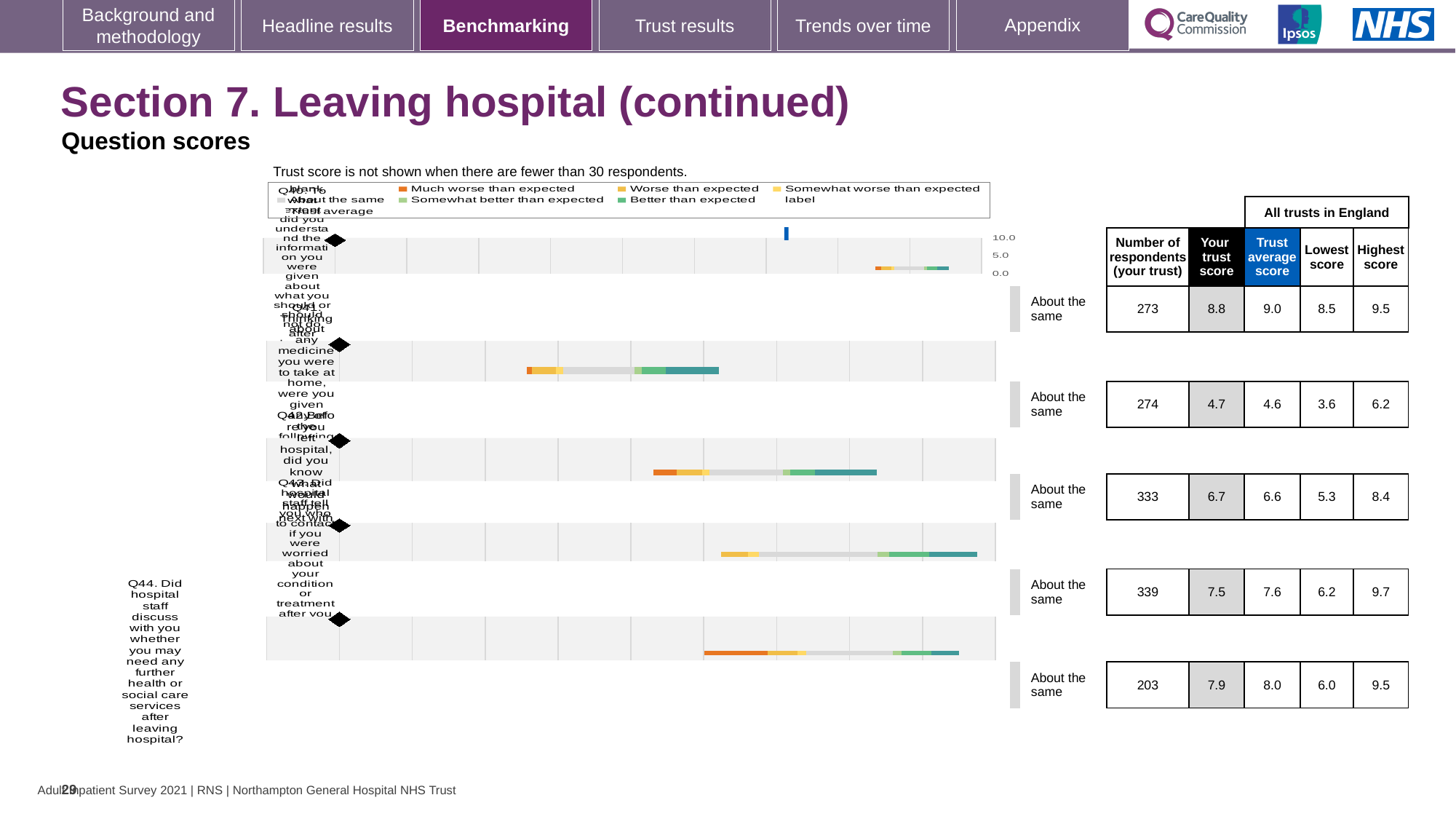
What is the difference between the highest score and the lowest score for Q41? 2.6 What is the trust average score shown for Q40? 9.0 What is the 'Your trust score' value for Q44 (Did hospital staff discuss with you whether you may need any further health or social care services after leaving hospital?)? 7.9 How many respondents (your trust) are shown for Q43? 339 How many questions are plotted on the chart? 5 What kind of chart is used to show the question scores? Bar chart What benchmark category is shown next to the chart for Q40? About the same Which question has the lowest 'Your trust score' on this slide? Q41 Is the trust score for Q41 greater or less than 5.0 on the chart's axis? less What is the highest score across all trusts in England for Q43? 9.7 Which question has the largest number of respondents (your trust)? Q43 For Q42, which is larger: the 'Your trust score' or the trust average score? Your trust score